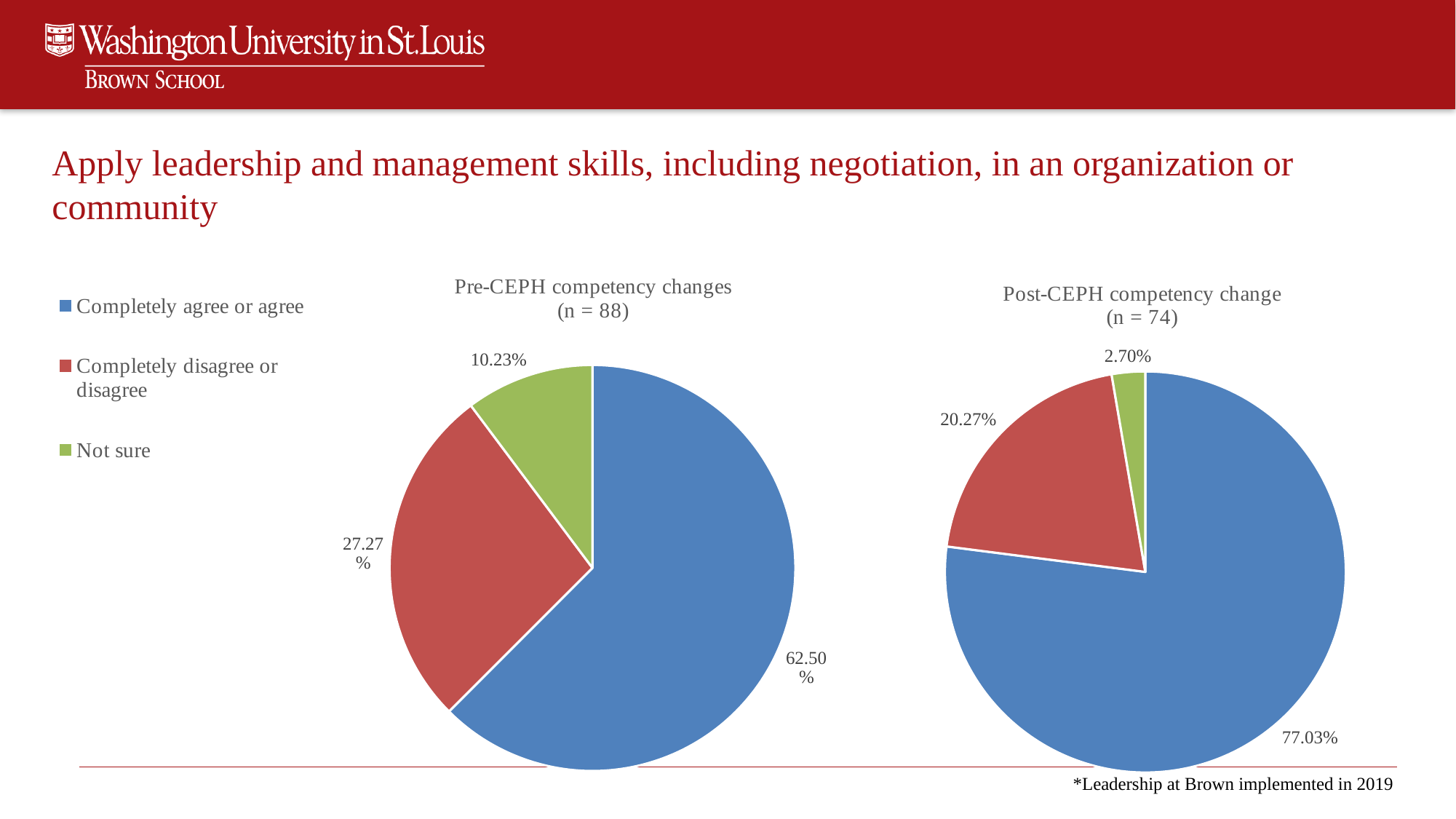
In the Pre-CEPH competency changes chart, which category has the largest slice? Completely agree or agree In the Post-CEPH competency change chart, which category has the smallest slice? Not sure In the Pre-CEPH competency changes chart, what share of respondents chose 'Completely agree or agree'? 62.50% In the Pre-CEPH competency changes chart, what share of respondents chose 'Not sure'? 10.23% What is the difference between the 'Completely agree or agree' share in the Post-CEPH chart and in the Pre-CEPH chart? 14.53% In the Post-CEPH competency change chart, what share of respondents chose 'Completely disagree or disagree'? 20.27% How many categories does the legend list? 3 Is the 'Completely disagree or disagree' share larger in the Pre-CEPH chart or the Post-CEPH chart? Pre-CEPH What is the sample size (n) shown in the title of the Post-CEPH competency change chart? 74 In the Post-CEPH competency change chart, what share of respondents chose 'Not sure'? 2.70% What colour represents 'Not sure' in the charts? Green What type of chart is used on this slide? Pie chart